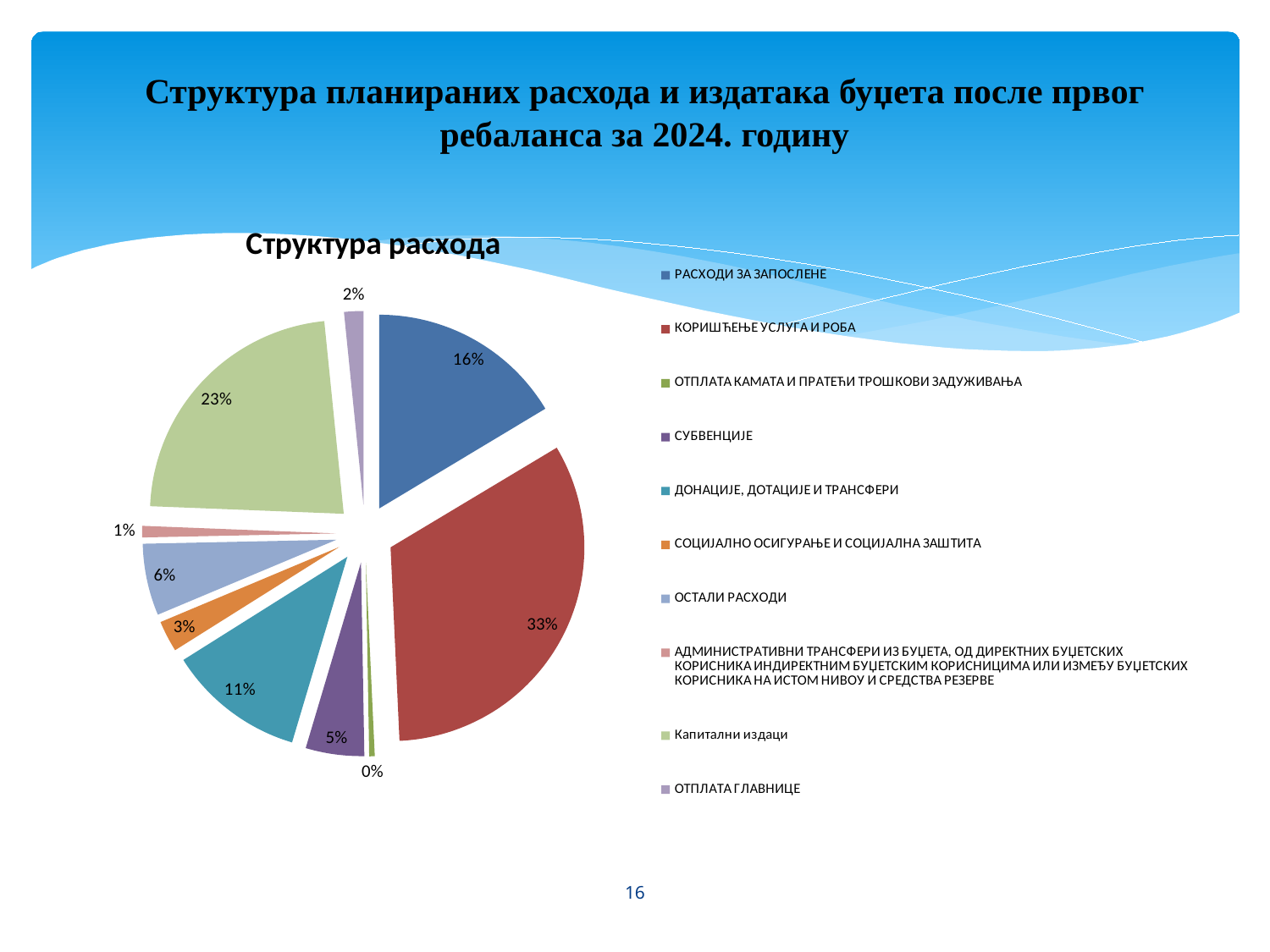
What share of the pie does КОРИШЋЕЊЕ УСЛУГА И РОБА have? 33% What share of the pie does ДОНАЦИЈЕ, ДОТАЦИЈЕ И ТРАНСФЕРИ have? 11% Which category has the smallest slice of the pie? ОТПЛАТА КАМАТА И ПРАТЕЋИ ТРОШКОВИ ЗАДУЖИВАЊА What share of the pie does СУБВЕНЦИЈЕ have? 5% What kind of chart is shown under the title "Структура расхода"? pie chart Which is larger, the slice for ОСТАЛИ РАСХОДИ or the slice for СОЦИЈАЛНО ОСИГУРАЊЕ И СОЦИЈАЛНА ЗАШТИТА? ОСТАЛИ РАСХОДИ What is the difference in percentage points between КОРИШЋЕЊЕ УСЛУГА И РОБА and Капитални издаци? 10 percentage points How many categories does the legend of the pie chart list? 10 Which category has the largest slice of the pie? КОРИШЋЕЊЕ УСЛУГА И РОБА